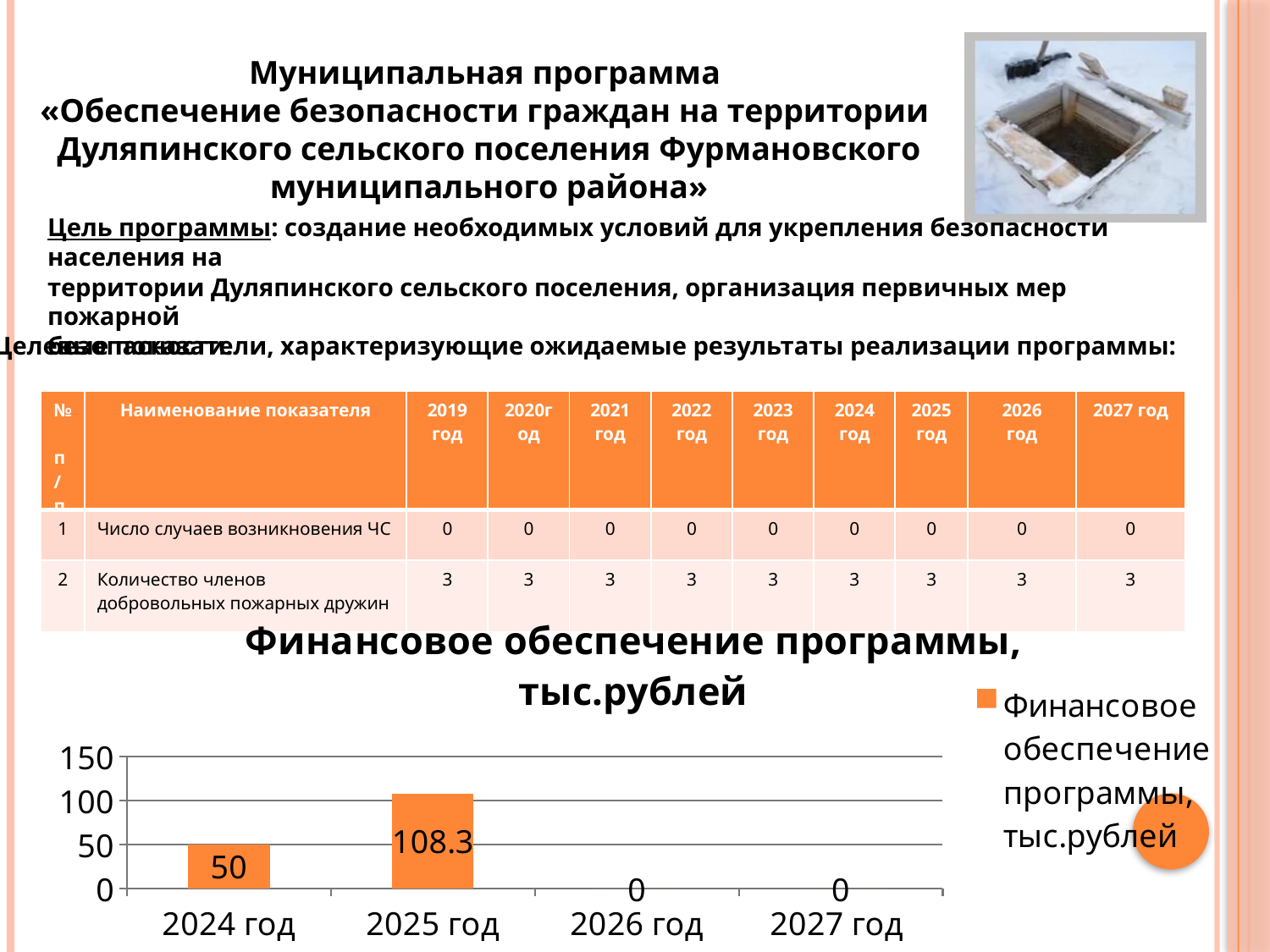
What is the value for 2026 год in the chart? 0 How many series does the chart legend list? 1 How many year categories are shown on the x axis of the chart? 4 What kind of chart is shown on the slide? bar chart What is the title of the chart? Финансовое обеспечение программы, тыс.рублей Is the value for 2025 год greater or less than 100? greater What is the difference between the values for 2025 год and 2024 год? 58.3 Which is larger, the value for 2024 год or the value for 2025 год? 2025 год Do the values rise or fall from 2025 год to 2026 год? fall What is the value for 2025 год in the chart? 108.3 What is the value for 2024 год in the chart? 50 Which year has the highest value in the chart? 2025 год